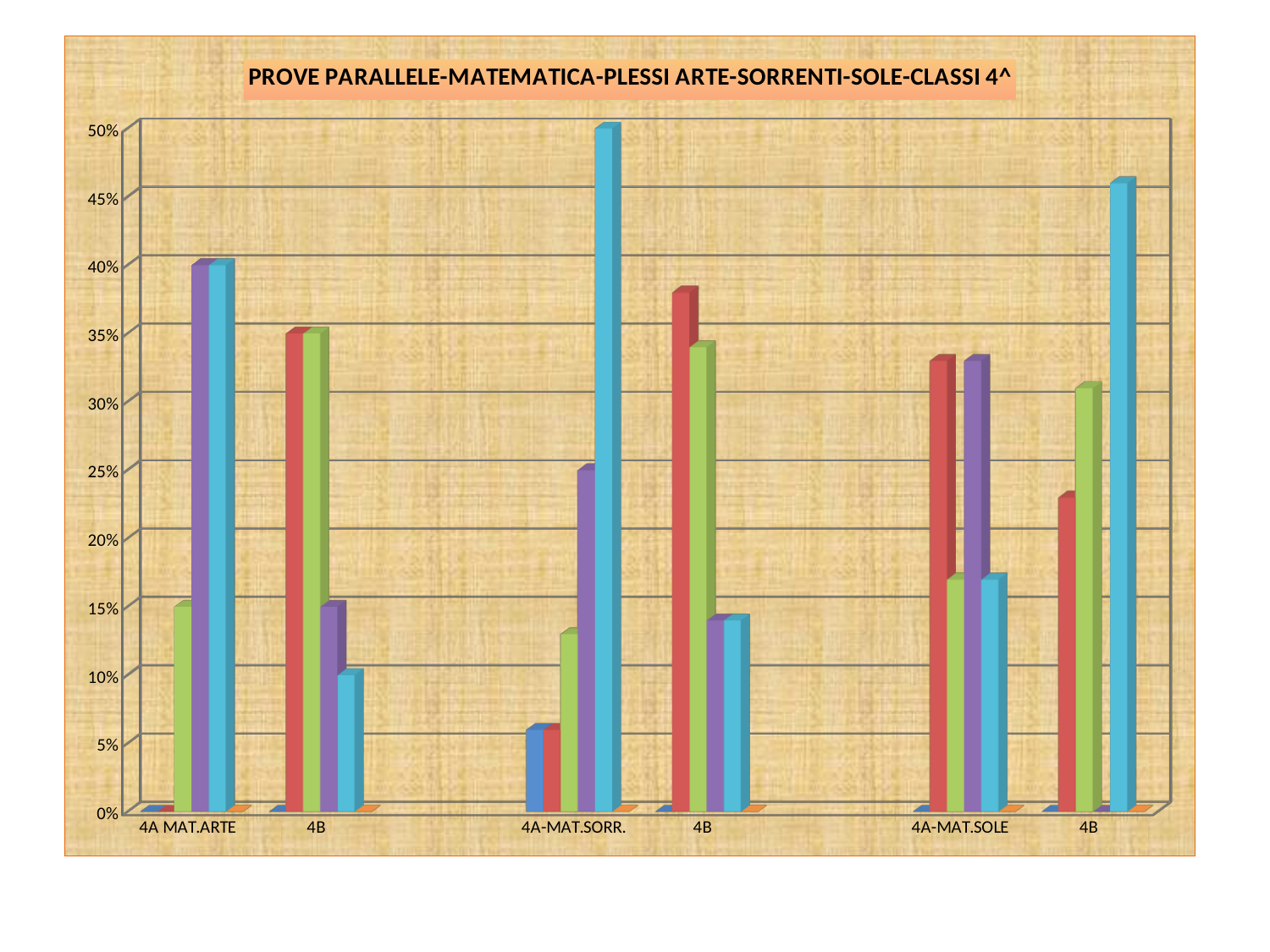
Is the value of the green bar for 4A MAT.ARTE greater or less than 20%? less What value does the light blue bar for 4A-MAT.SORR. reach? 50% How many categories are shown along the x axis of the chart? 6 What kind of chart is shown on the slide? bar chart Is the value of the red bar for the 4B category next to 4A-MAT.SORR. greater or less than 35%? greater Is the value of the purple bar for 4A-MAT.SORR. greater or less than 30%? less What is the title of the chart? PROVE PARALLELE-MATEMATICA-PLESSI ARTE-SORRENTI-SOLE-CLASSI 4^ In the 4A-MAT.SOLE category, which is larger: the red bar or the green bar? the red bar Which is larger: the light blue bar for 4A MAT.ARTE or the light blue bar for the 4B category next to it? 4A MAT.ARTE Which category contains the tallest bar in the chart? 4A-MAT.SORR.